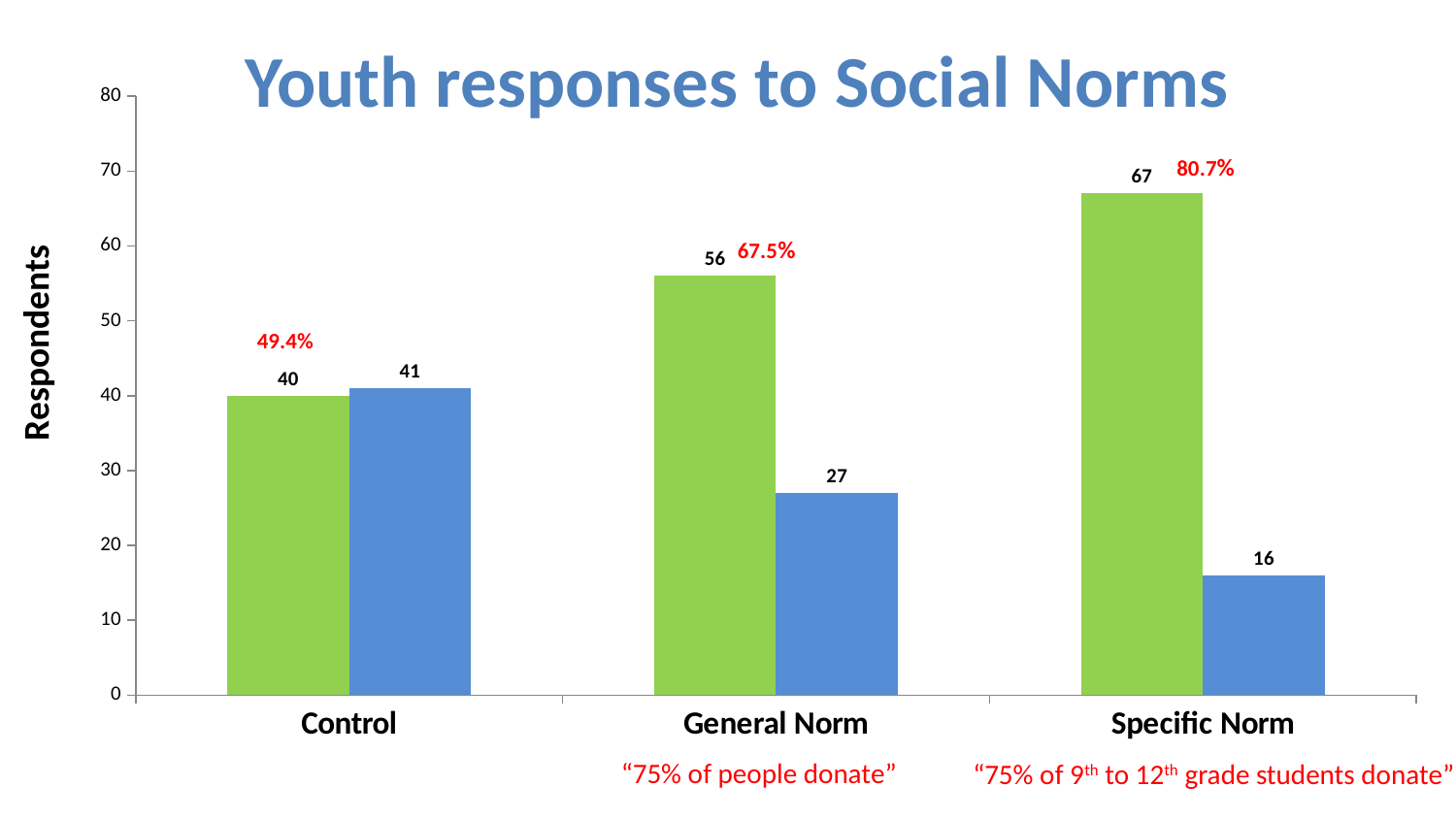
Which category has the highest green bar? Specific Norm What is the value of the green bar for Specific Norm? 67 What is the value of the blue bar for Control? 41 How many categories are shown on the x axis? 3 What is the title of the chart? Youth responses to Social Norms What percentage is shown in red above the General Norm bars? 67.5% What is the difference between the green bar and the blue bar for Specific Norm? 51 Which is larger for Control, the green bar or the blue bar? the blue bar What is the difference between the green bars for General Norm and Control? 16 What kind of chart is shown on the slide? bar chart What is the value of the blue bar for General Norm? 27 Which category has the lowest blue bar? Specific Norm